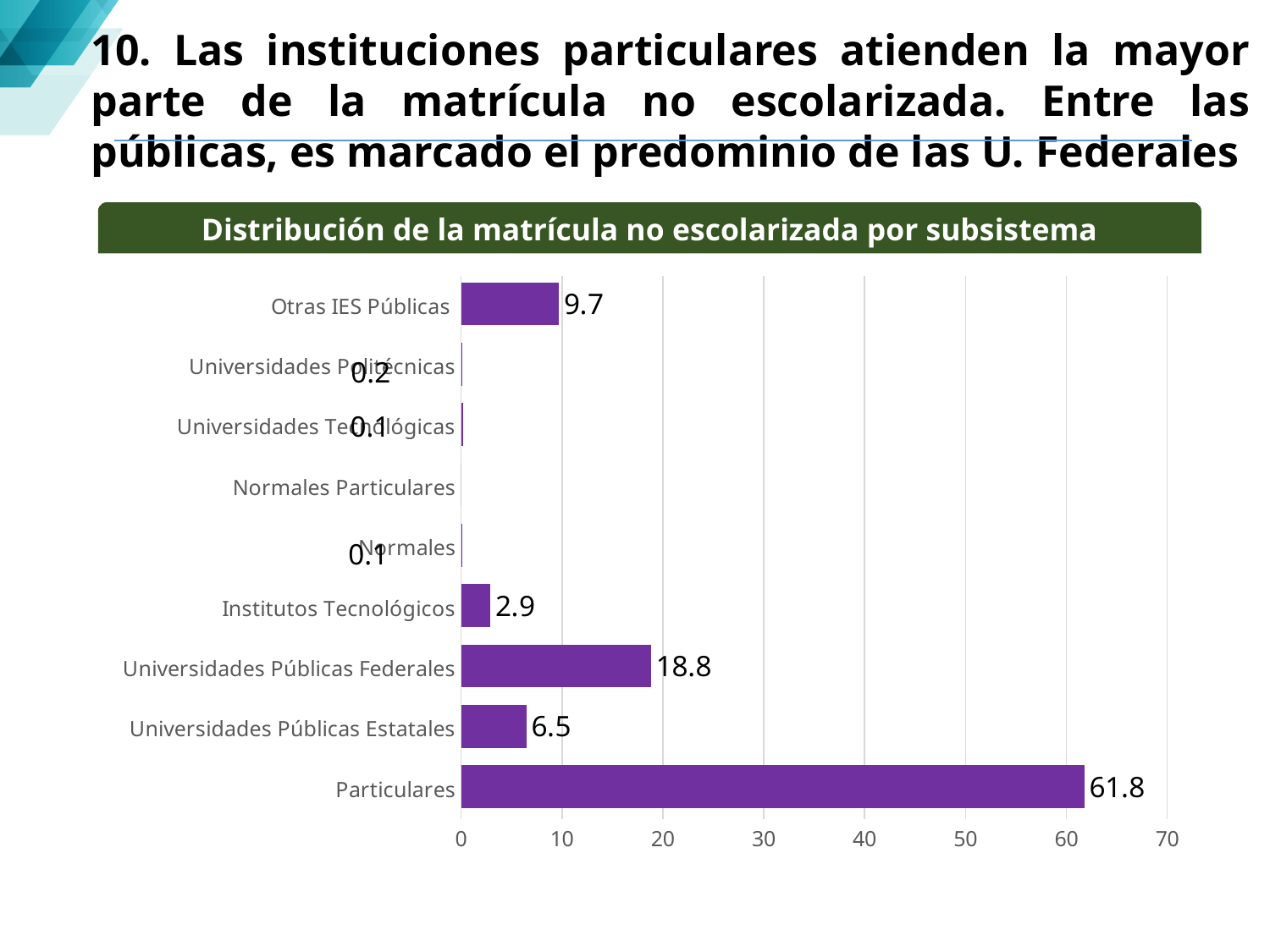
What kind of chart is shown on the slide? bar chart What is the value for Otras IES Públicas? 9.7 What is the value for Universidades Públicas Federales? 18.8 What is the value for Universidades Públicas Estatales? 6.5 What is the difference between the values for Otras IES Públicas and Universidades Públicas Estatales? 3.2 Which category has the highest value? Particulares How many categories are shown in the chart? 9 Which is larger, the value for Universidades Públicas Federales or the value for Universidades Públicas Estatales? Universidades Públicas Federales Is the value for Particulares greater or less than 60? greater What is the difference between the values for Particulares and Universidades Públicas Federales? 43.0 What is the value for Institutos Tecnológicos? 2.9 What is the value for Particulares? 61.8